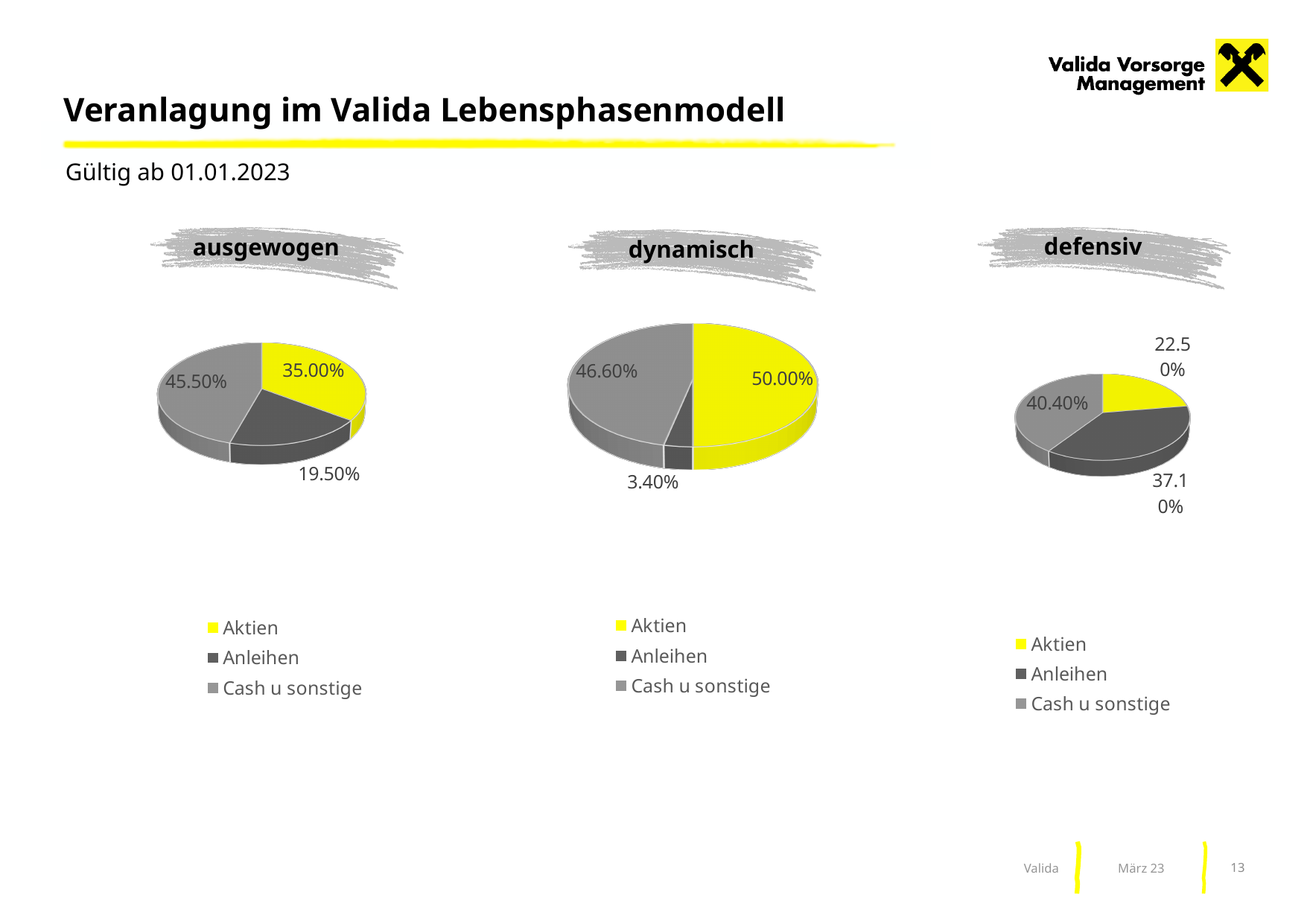
In the 'defensiv' pie chart, what is the share for Cash u sonstige? 40.40% How many categories does the legend of the 'dynamisch' chart list? 3 In the 'ausgewogen' pie chart, what is the share for Cash u sonstige? 45.50% In the 'dynamisch' pie chart, what is the share for Anleihen? 3.40% In the 'ausgewogen' pie chart, which category has the largest slice? Cash u sonstige In the 'defensiv' pie chart, which is larger, Aktien or Anleihen? Anleihen What type of chart is used on this slide? Pie chart In the 'dynamisch' pie chart, which category has the smallest slice? Anleihen In the 'ausgewogen' pie chart, what is the share for Anleihen? 19.50% In the 'dynamisch' pie chart, what is the share for Aktien? 50.00% In the 'ausgewogen' pie chart, what is the share for Aktien? 35.00% In the 'ausgewogen' pie chart, what is the difference between the Cash u sonstige share and the Aktien share? 10.50%